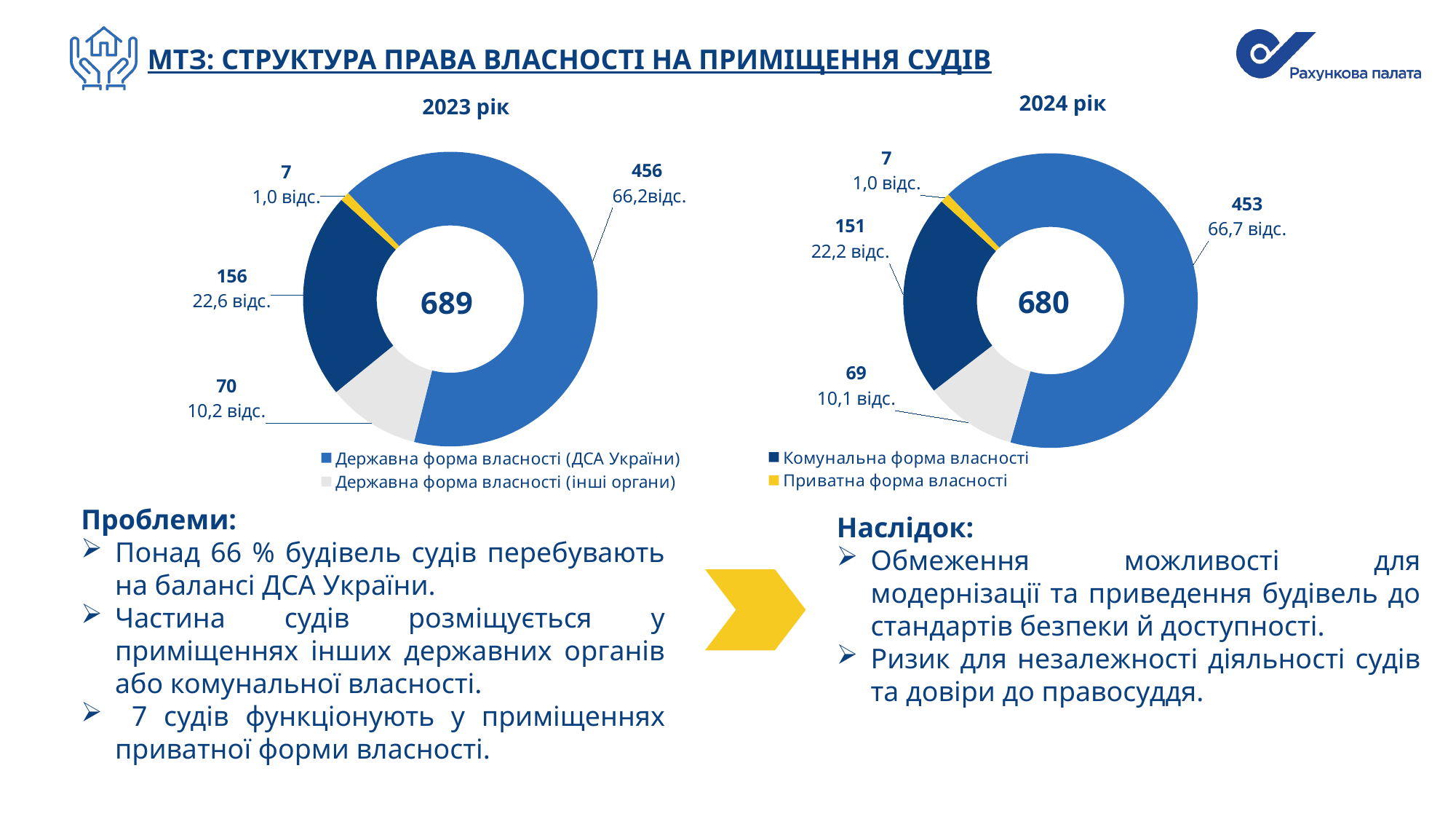
In the 2024 рік chart, what share does Державна форма власності (ДСА України) have? 66,7 відс. Which is larger: Комунальна форма власності in 2023 рік or in 2024 рік? 2023 рік How many categories does the 2023 рік chart show? 4 In the 2023 рік chart, what is the difference between Комунальна форма власності and Державна форма власності (інші органи)? 86 In the 2024 рік chart, which category has the smallest value? Приватна форма власності What total is shown in the centre of the 2024 рік chart? 680 In the 2023 рік chart, what is the value for Державна форма власності (ДСА України)? 456 In the 2023 рік chart, which category has the largest value? Державна форма власності (ДСА України) What type of chart is used for 2023 рік and 2024 рік? Donut (pie) chart In the 2023 рік chart, what share does Державна форма власності (інші органи) have? 10,2 відс. In the 2024 рік chart, what is the value for Комунальна форма власності? 151 Which colour represents Приватна форма власності in the legend? Yellow